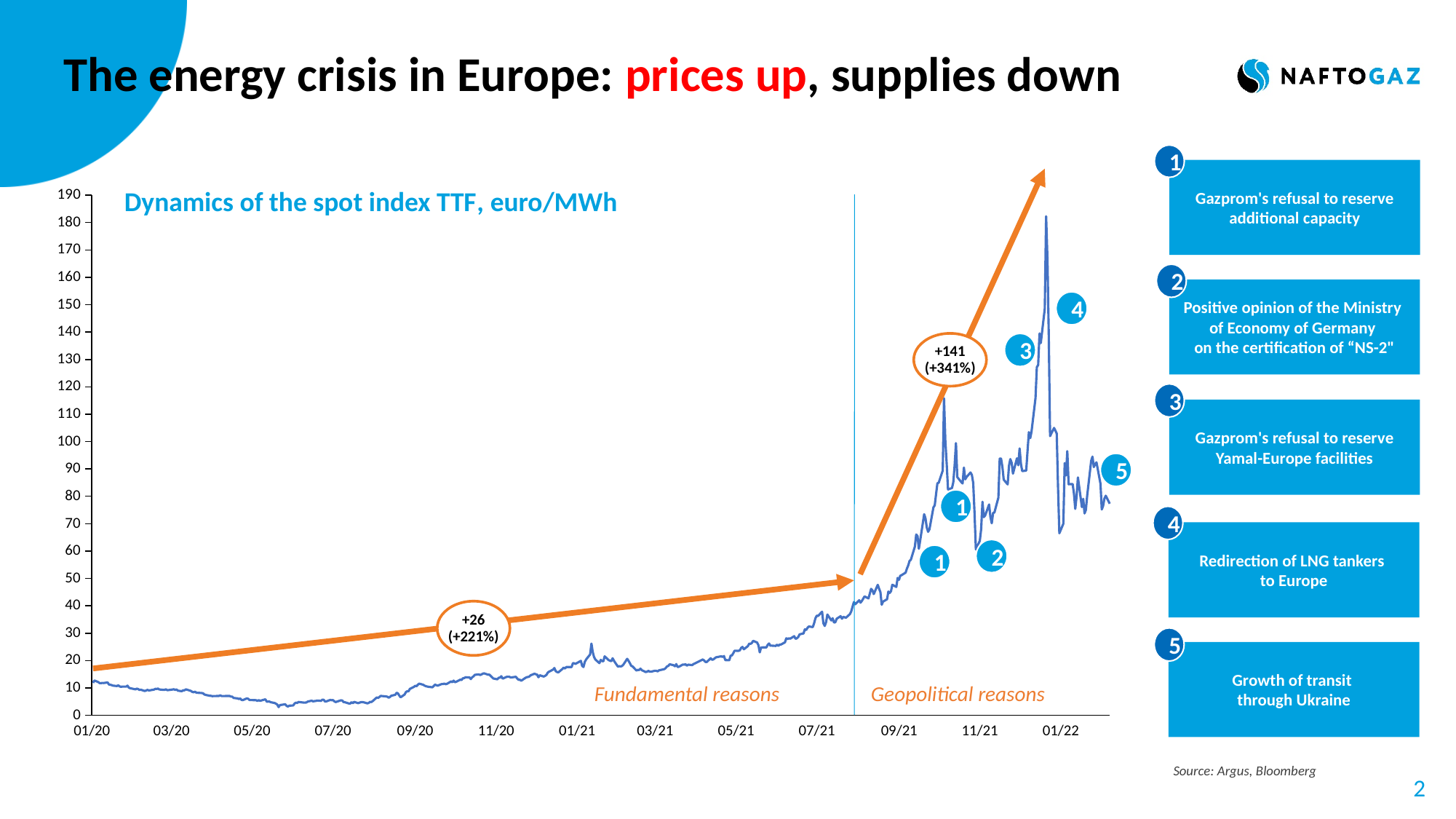
What percentage increase is shown in the annotation over the 'Geopolitical reasons' period? +341% What is the highest value shown on the y axis of the chart? 190 What absolute increase is shown in the annotation over the 'Fundamental reasons' period? +26 What is the title of the chart? Dynamics of the spot index TTF, euro/MWh What absolute increase is shown in the annotation over the 'Geopolitical reasons' period? +141 Is the value of the TTF spot index at 07/21 greater or less than 30? greater Is the peak value of the TTF spot index in the chart greater or less than 170? greater Overall, does the TTF spot index rise or fall from 01/20 to 01/22? rise How many date labels are shown along the x axis of the chart? 13 Is the value of the TTF spot index at 05/20 greater or less than 10? less What percentage increase is shown in the annotation over the 'Fundamental reasons' period? +221% What kind of chart is shown on the slide? line chart